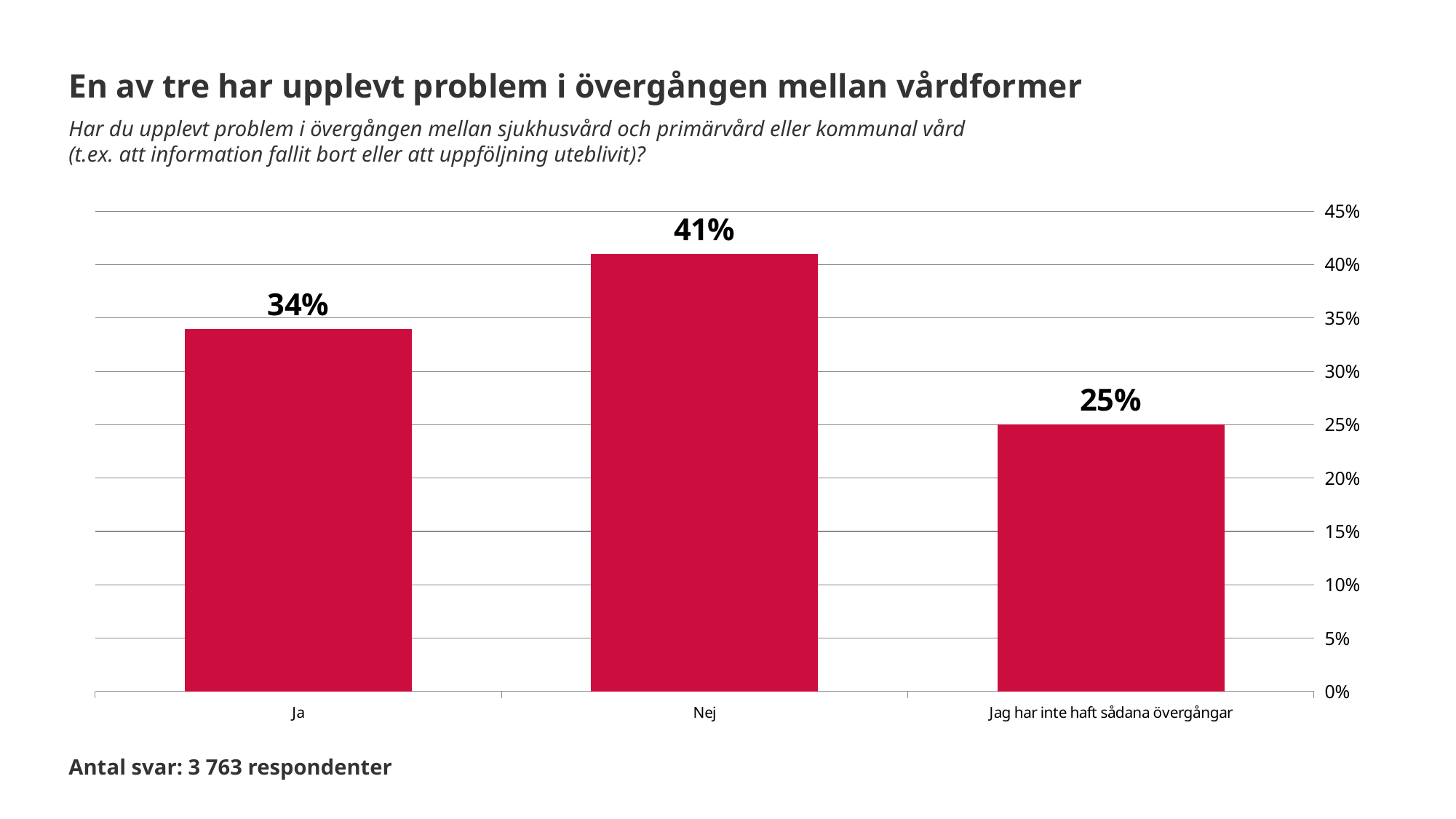
Which category has the highest value? Nej What is the difference between the values for "Ja" and "Jag har inte haft sådana övergångar"? 9% How many categories are shown on the chart? 3 What is the value for "Jag har inte haft sådana övergångar"? 25% Which is larger, the value for "Ja" or the value for "Jag har inte haft sådana övergångar"? Ja Is the value for "Nej" greater or less than 40%? greater What kind of chart is shown on the slide? Bar chart What is the difference between the values for "Nej" and "Ja"? 7% How many respondents does the slide say answered the question? 3 763 respondenter What is the value for "Nej"? 41% Which category has the lowest value? Jag har inte haft sådana övergångar What is the value for "Ja"? 34%